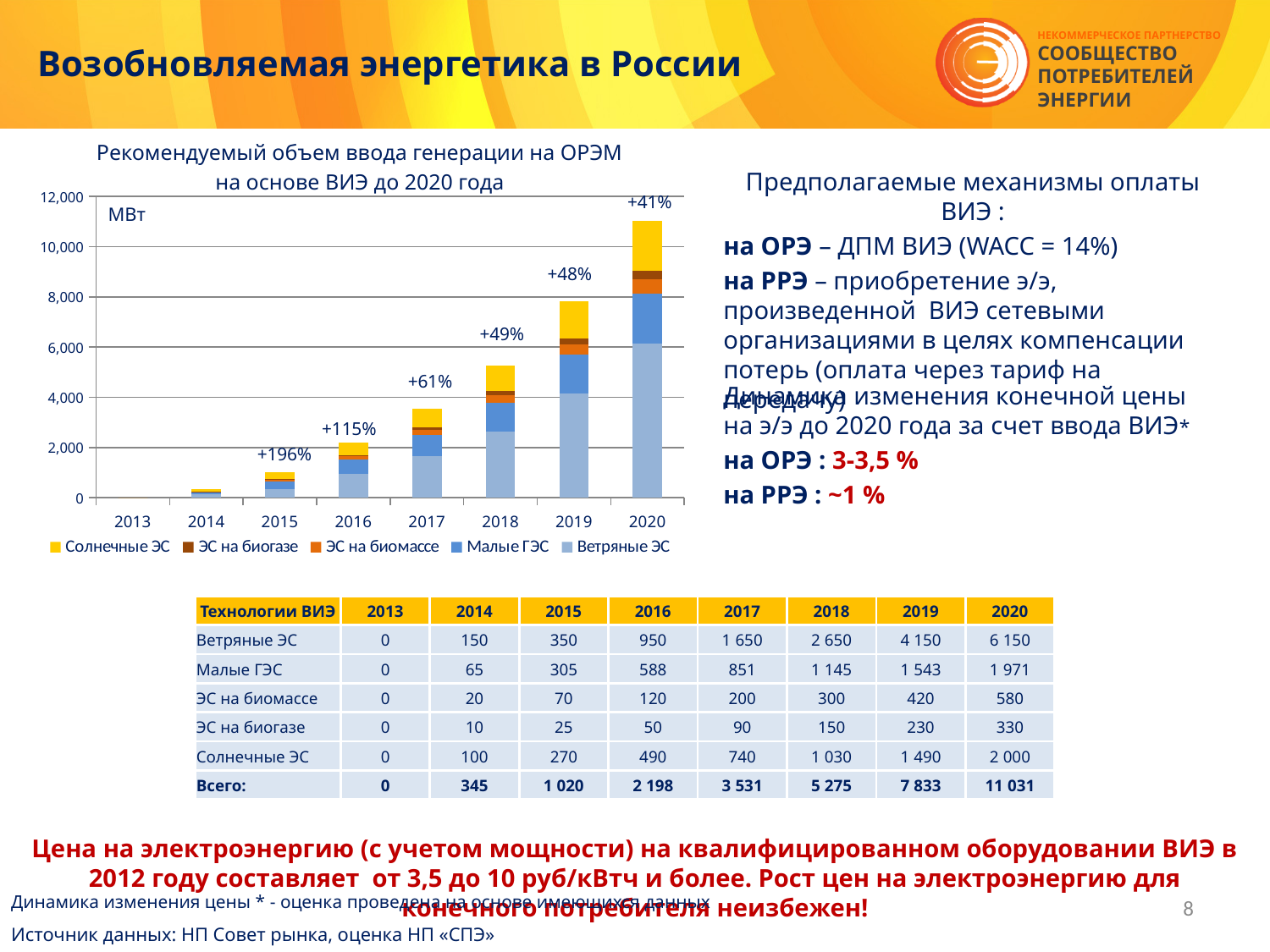
What unit label is shown in the top-left corner of the bar chart's plot area? МВт Is the total stacked bar value for 2017 greater or less than 4,000? less Which year has the tallest stacked bar? 2020 What percentage label is printed above the 2020 bar? +41% How many series does the legend of the bar chart list? 5 How many years are shown along the x axis of the bar chart? 8 What percentage label is printed above the 2015 bar? +196% According to the table under the chart, what is the value for Ветряные ЭС in 2020? 6 150 According to the table under the chart, what is the total (Всего) for 2020? 11 031 What kind of chart is used to show the recommended volume of renewable generation commissioning up to 2020? bar chart Do the stacked bar totals rise or fall from 2013 to 2020? rise Is the total stacked bar value for 2019 greater or less than 6,000? greater